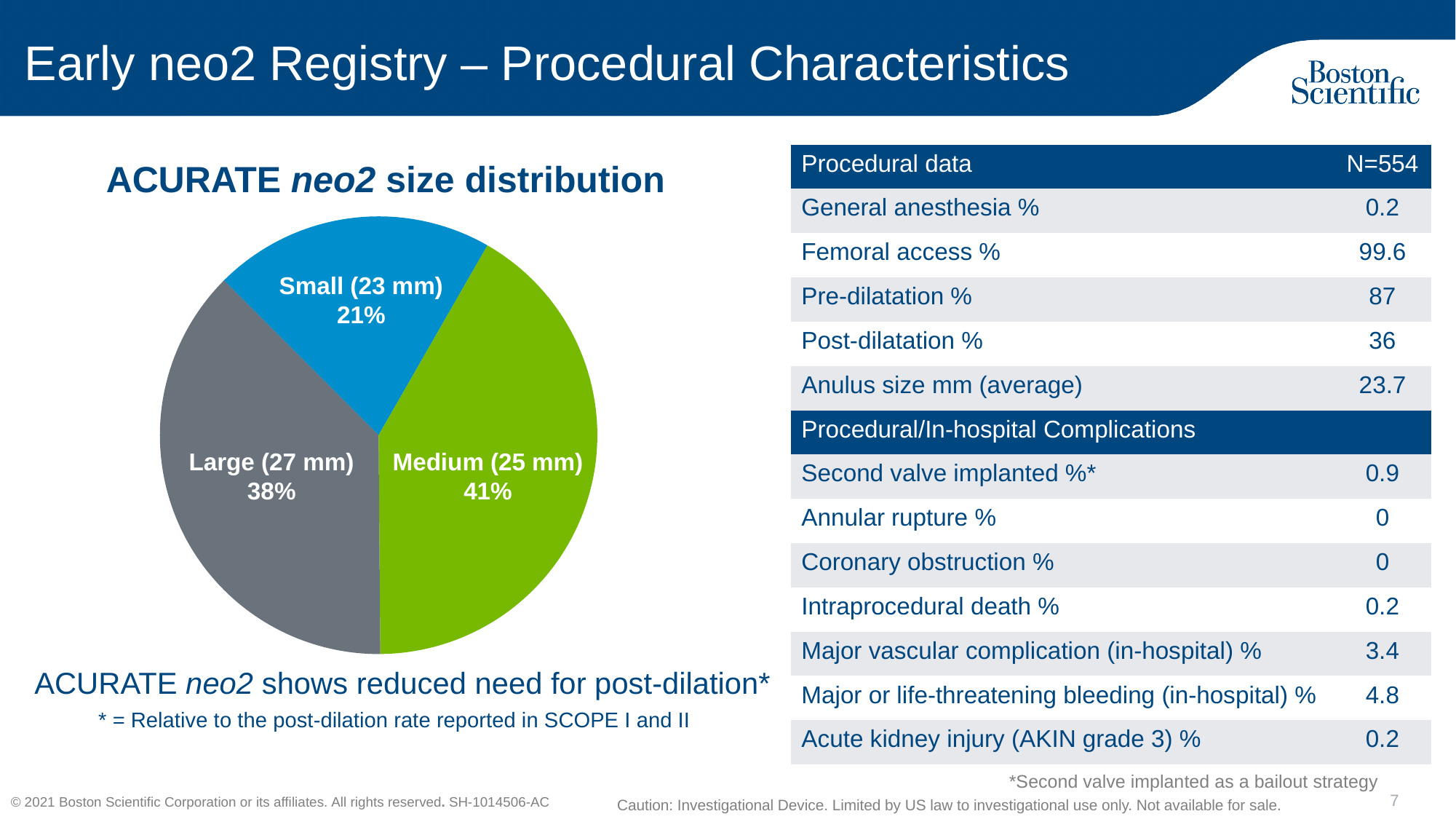
What is the difference in percentage points between the Medium (25 mm) and Large (27 mm) slices? 3 What is the difference in percentage points between the Large (27 mm) and Small (23 mm) slices? 17 What kind of chart is shown on the slide? Pie chart What colour is the Medium (25 mm) slice of the pie chart? Green What share of the pie does Small (23 mm) represent? 21% What is the value for Large (27 mm) in the pie chart? 38% What is the title of the pie chart? ACURATE neo2 size distribution Which valve size has the largest share of the pie? Medium (25 mm) Which is larger, the Small (23 mm) slice or the Large (27 mm) slice? Large (27 mm) What is the value for Medium (25 mm) in the pie chart? 41% How many slices does the pie chart have? 3 Which valve size has the smallest share of the pie? Small (23 mm)